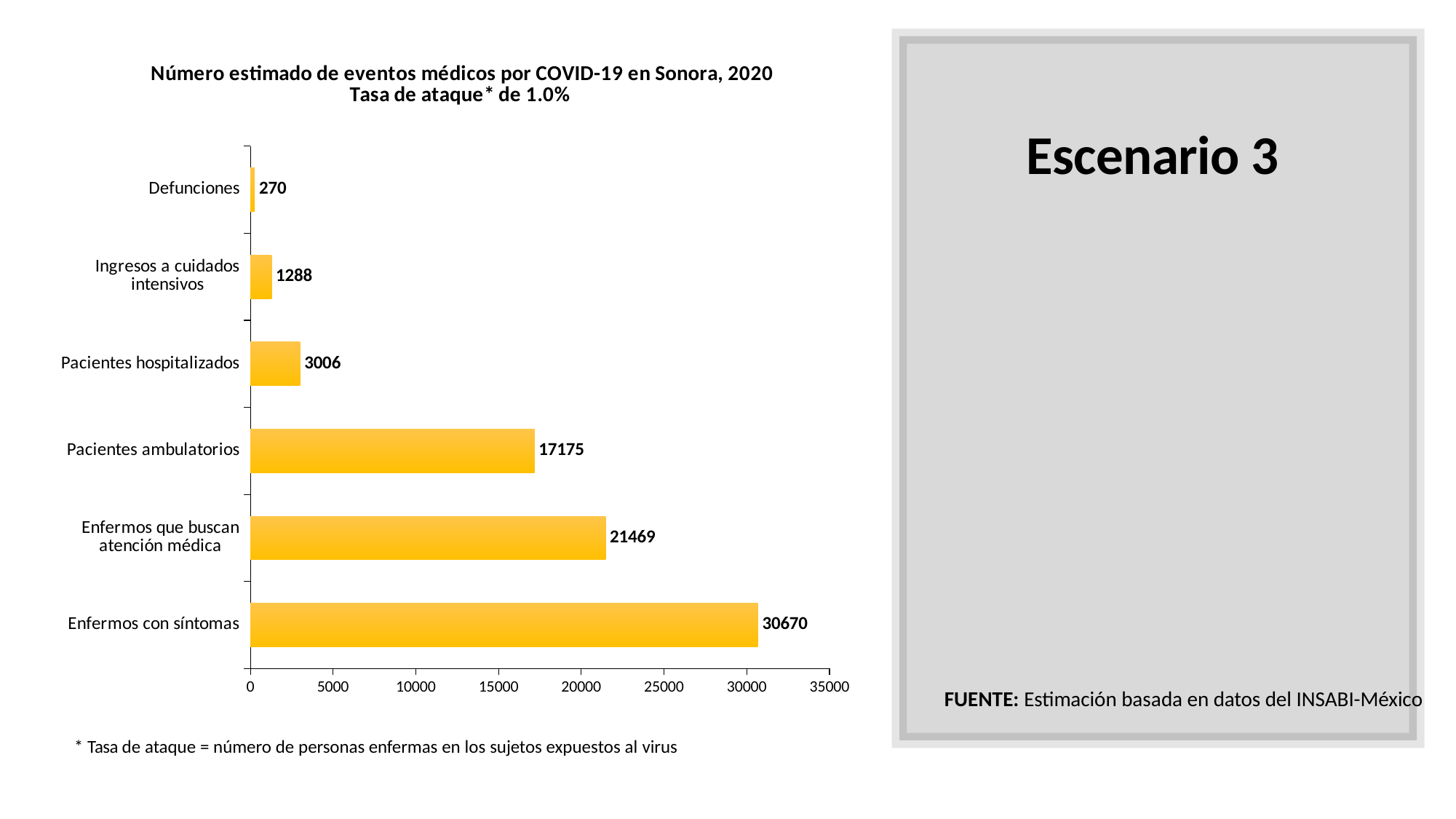
What is the difference between Enfermos con síntomas and Defunciones? 30400 What kind of chart is shown on the slide? bar chart Which category has the highest value? Enfermos con síntomas Which category has the lowest value? Defunciones What is the difference between Enfermos que buscan atención médica and Pacientes ambulatorios? 4294 Is the value for Pacientes ambulatorios greater or less than 15000? greater What is the value for Ingresos a cuidados intensivos? 1288 Which is larger, Pacientes hospitalizados or Ingresos a cuidados intensivos? Pacientes hospitalizados What is the value for Enfermos con síntomas? 30670 How many categories are shown in the chart? 6 What attack rate (tasa de ataque) is stated in the chart title? 1.0% What is the value for Pacientes hospitalizados? 3006